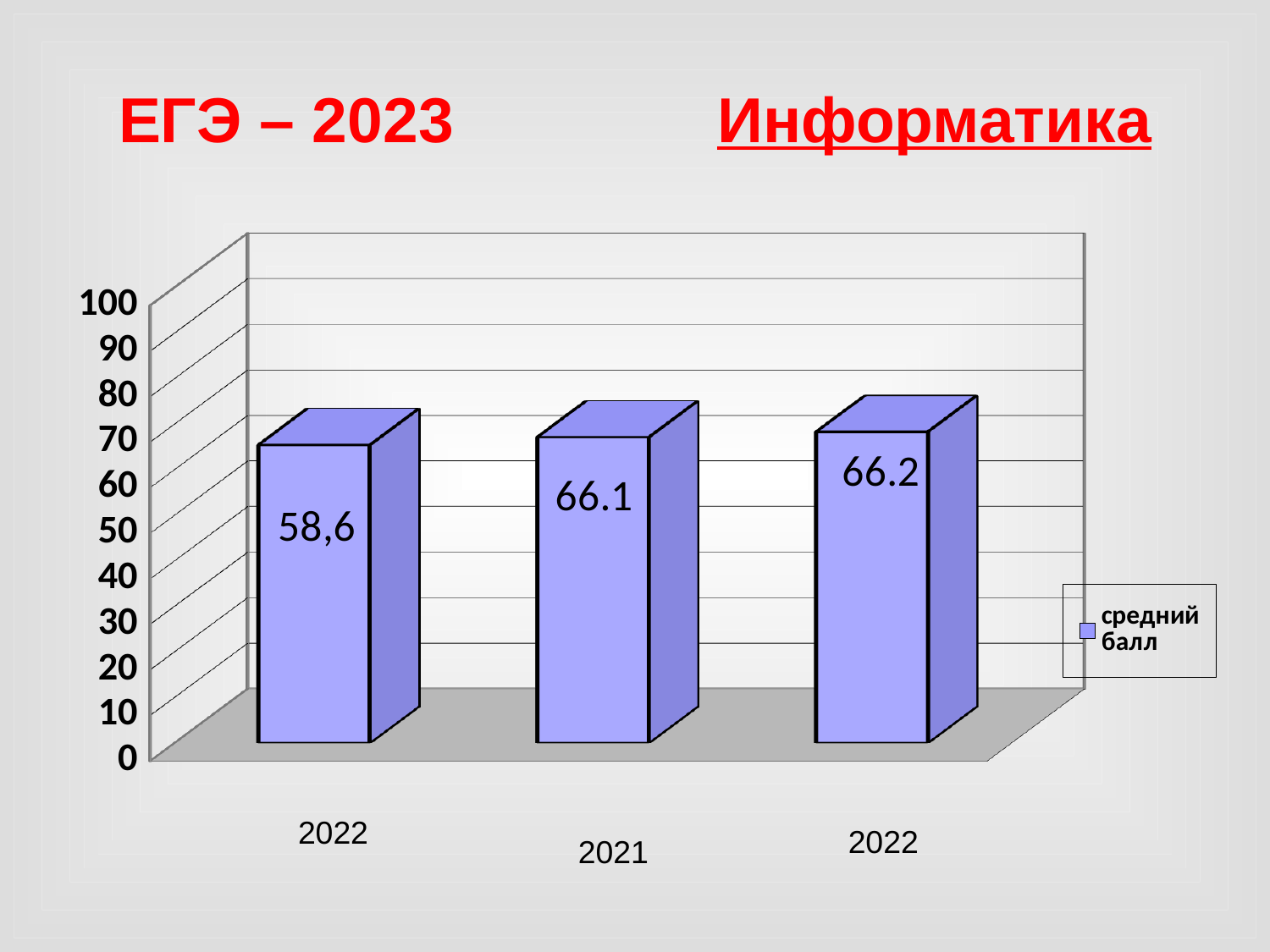
What is the difference between the 2021 bar and the leftmost bar? 7.5 Is the value of the leftmost bar greater or less than 50? greater What is the legend entry of the chart? средний балл What value is printed on the rightmost bar? 66.2 What kind of chart is shown on the slide? bar chart Which bar has the lowest value? the leftmost bar (58,6) Which bar has the highest value? the rightmost bar (66.2) What value is printed on the bar for 2021? 66.1 Which is larger: the value for 2021 or the value of the leftmost bar? 2021 What value is printed on the leftmost bar (labelled 2022)? 58,6 How many series does the legend list? 1 How many bars are plotted in the chart? 3